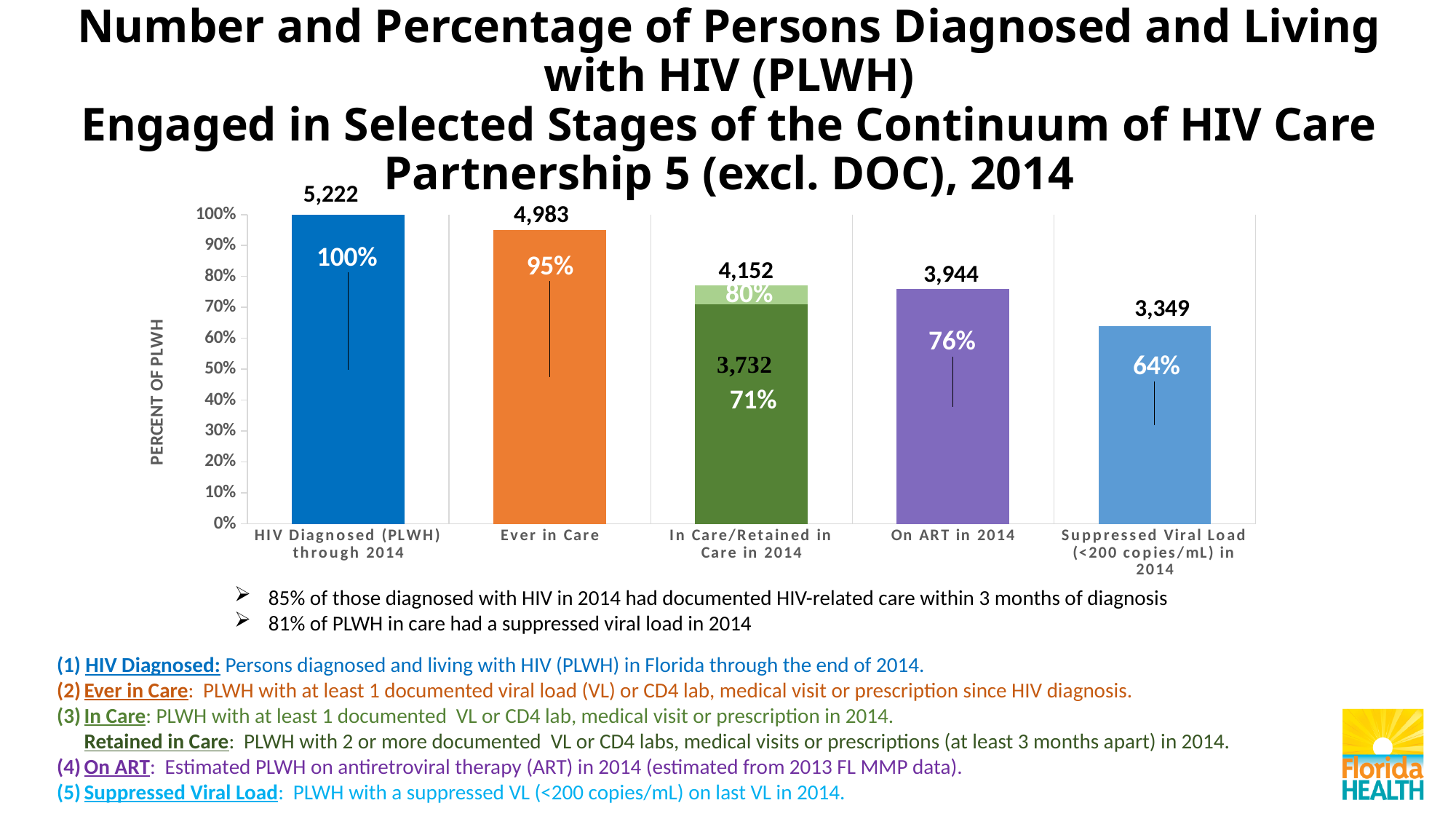
How many categories are shown on the x axis of the chart? 5 What is the number of persons labelled on the 'HIV Diagnosed (PLWH) through 2014' bar? 5,222 Which category has the highest value in the chart? HIV Diagnosed (PLWH) through 2014 Do the values rise or fall moving from left to right across the x axis? fall What percentage is shown on the 'Ever in Care' bar? 95% What number is labelled at the top of the 'In Care/Retained in Care in 2014' bar? 4,152 Which category has the lowest value in the chart? Suppressed Viral Load (<200 copies/mL) in 2014 What percentage is shown on the 'Suppressed Viral Load (<200 copies/mL) in 2014' bar? 64% What kind of chart is shown on the slide? bar chart What percentage is shown for the retained-in-care (darker green) portion of the 'In Care/Retained in Care in 2014' bar? 71% What is the number labelled on the 'On ART in 2014' bar? 3,944 What is the difference in number of persons between 'Ever in Care' and 'On ART in 2014'? 1,039